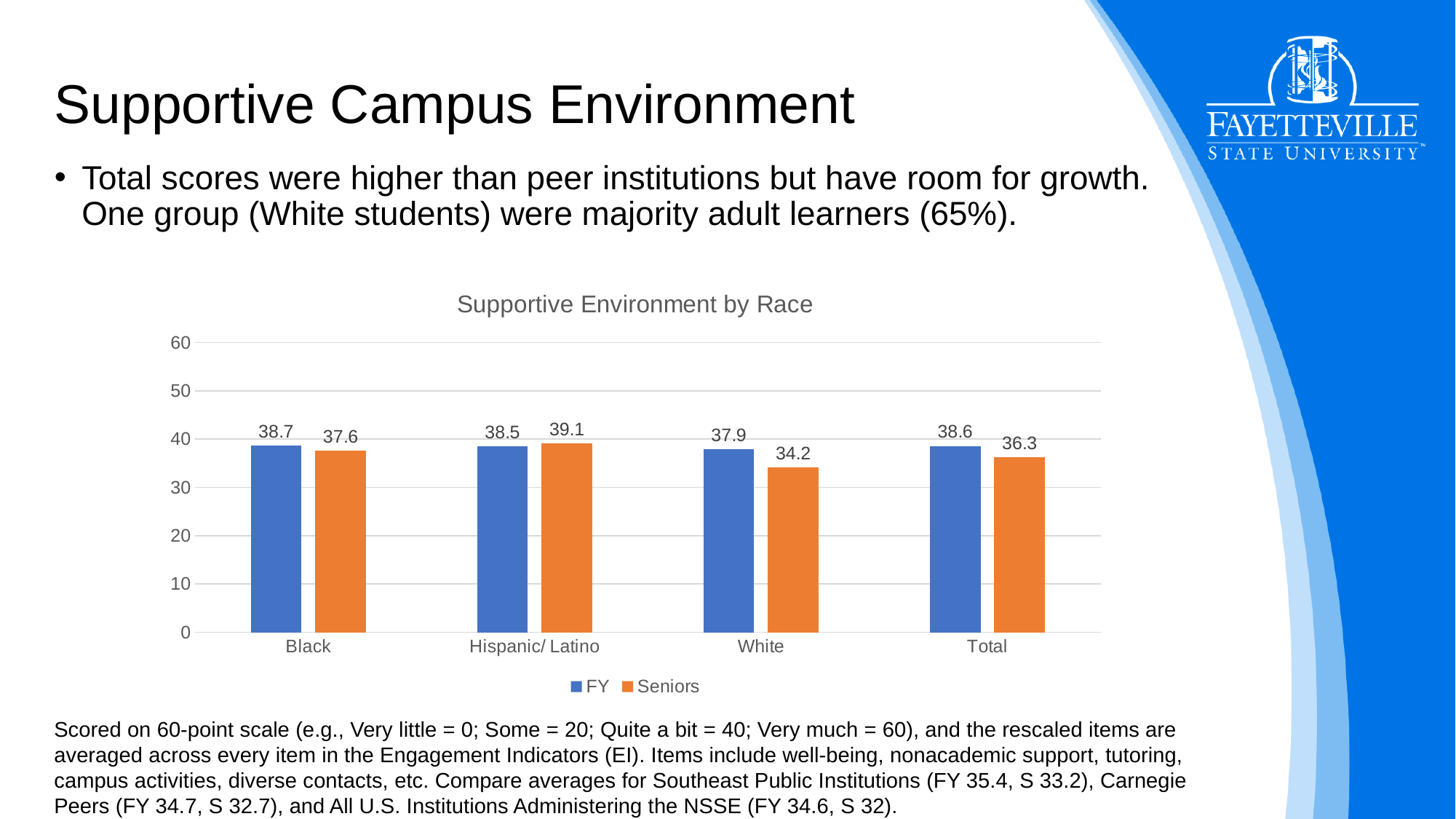
How many series does the chart legend list? 2 Which category has the lowest Seniors value? White What is the difference between the FY and Seniors values for White students? 3.7 What is the difference between the FY and Seniors values for the Total category? 2.3 What is the Seniors value for Hispanic/ Latino students? 39.1 How many categories are shown on the x axis of the chart? 4 What is the FY value for Black students in the Supportive Environment by Race chart? 38.7 What type of chart is shown on the slide? bar chart Which category has the highest Seniors value? Hispanic/ Latino Which is larger for Hispanic/ Latino students, the FY value or the Seniors value? Seniors Is the Seniors value for White students greater or less than 40? less What is the Seniors value for White students? 34.2